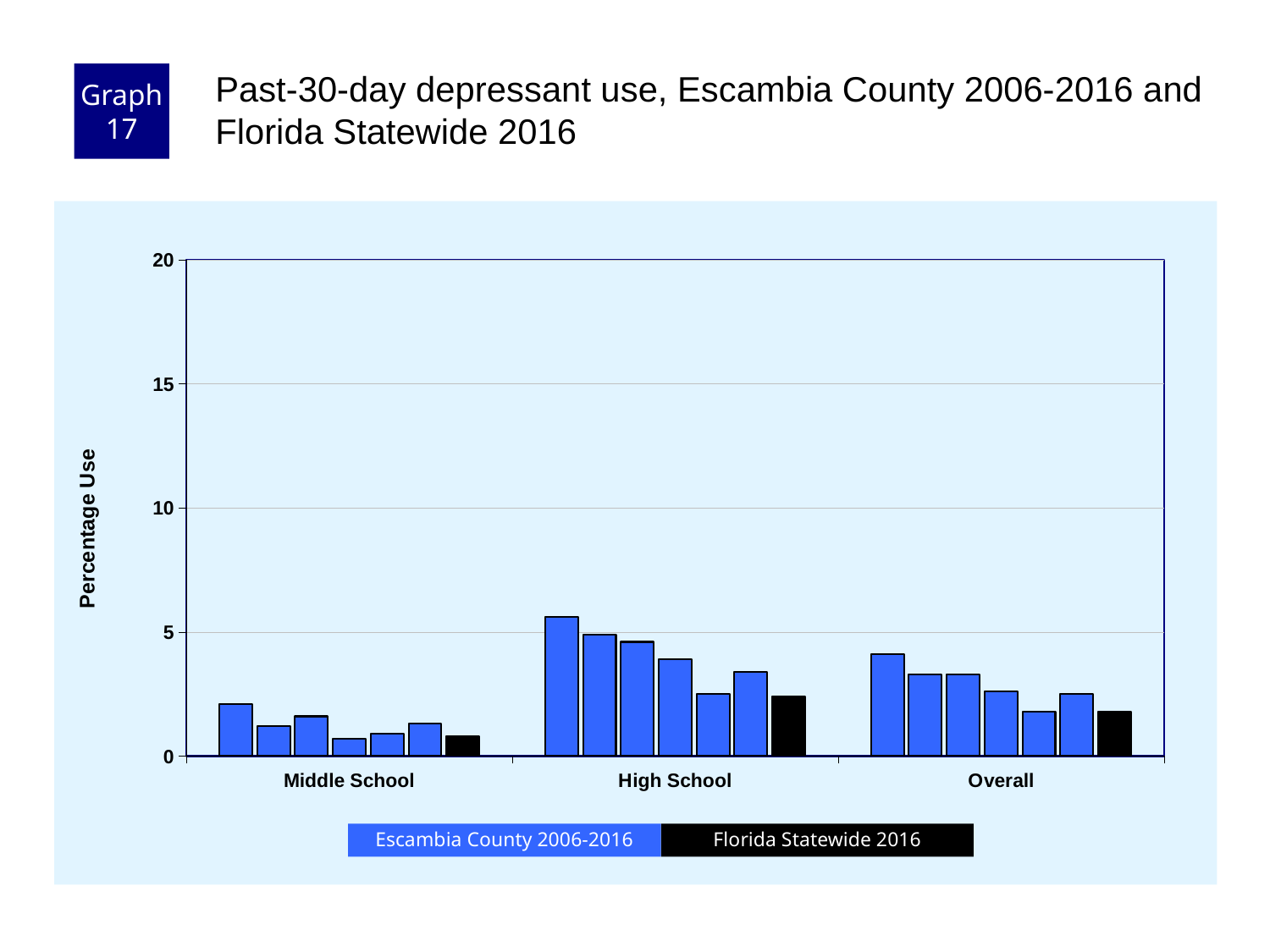
Is the value for the first Escambia County bar in High School greater or less than 5? greater What kind of chart is shown on the slide? bar chart What is the label on the y axis? Percentage Use Which category has the shortest bars overall? Middle School How many series does the legend list? 2 Is the value for the first Escambia County bar in Overall greater or less than 5? less Is the value for the Florida Statewide 2016 bar in Middle School greater or less than 5? less How many categories are shown on the x axis? 3 Which category has the tallest bar overall? High School Which is larger, the Florida Statewide 2016 bar for High School or the Florida Statewide 2016 bar for Middle School? High School What colour represents Florida Statewide 2016 in the legend? black